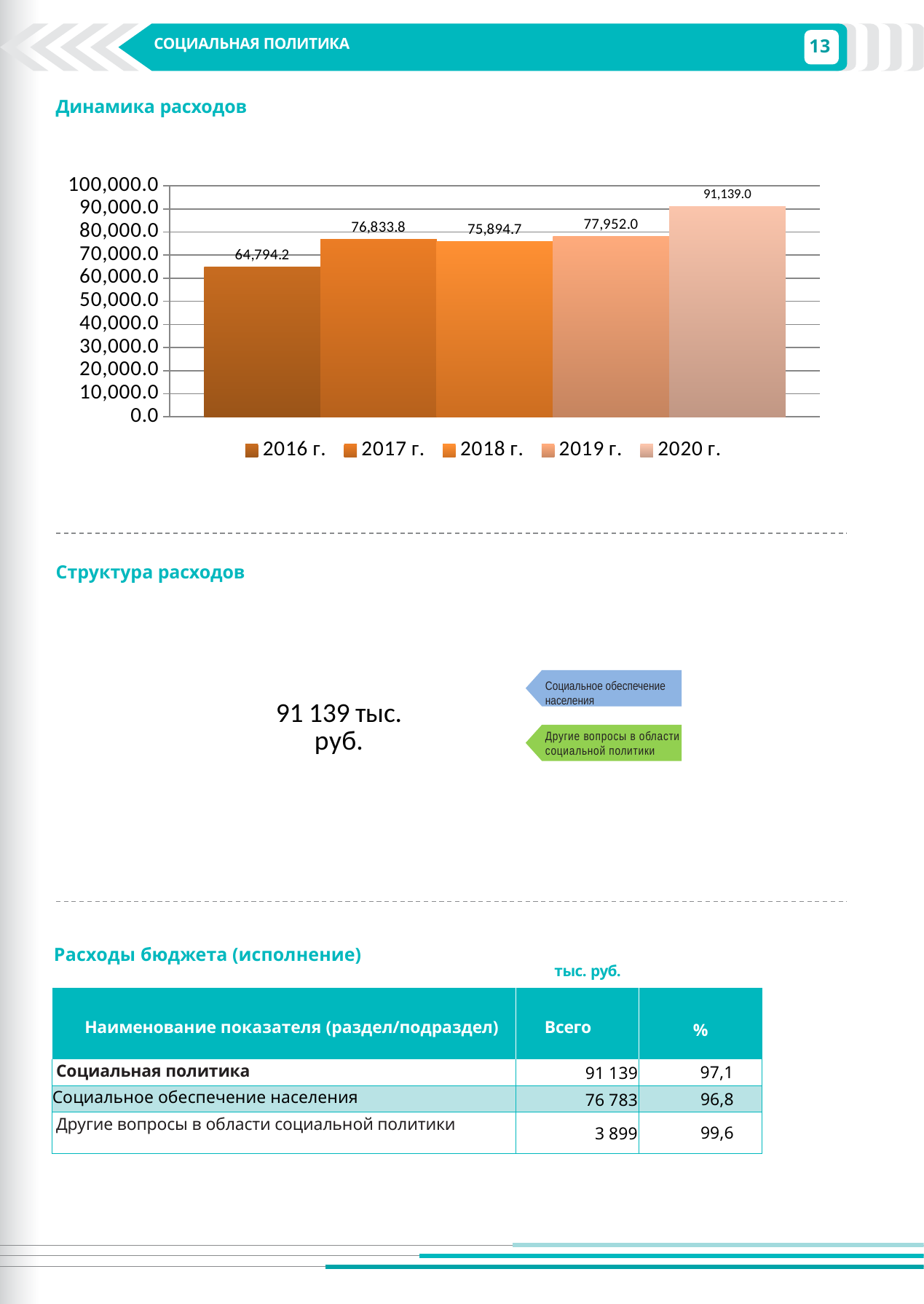
How many bars are plotted in the 'Динамика расходов' chart? 5 In the 'Динамика расходов' chart, what is the difference between the values for 2020 г. and 2016 г.? 26,344.8 In the 'Динамика расходов' chart, what is the value for 2018 г.? 75,894.7 In the 'Динамика расходов' chart, which year has the highest value? 2020 г. How many entries does the legend of the 'Динамика расходов' chart list? 5 In the 'Динамика расходов' chart, what is the value for 2016 г.? 64,794.2 What type of chart is the 'Динамика расходов' chart? bar chart In the 'Динамика расходов' chart, what is the difference between the values for 2017 г. and 2018 г.? 939.1 In the 'Динамика расходов' chart, is the value for 2016 г. greater or less than 70,000.0? less In the 'Динамика расходов' chart, which year has the lowest value? 2016 г. In the 'Динамика расходов' chart, what is the value for 2019 г.? 77,952.0 In the 'Динамика расходов' chart, which is larger: the value for 2017 г. or 2018 г.? 2017 г.